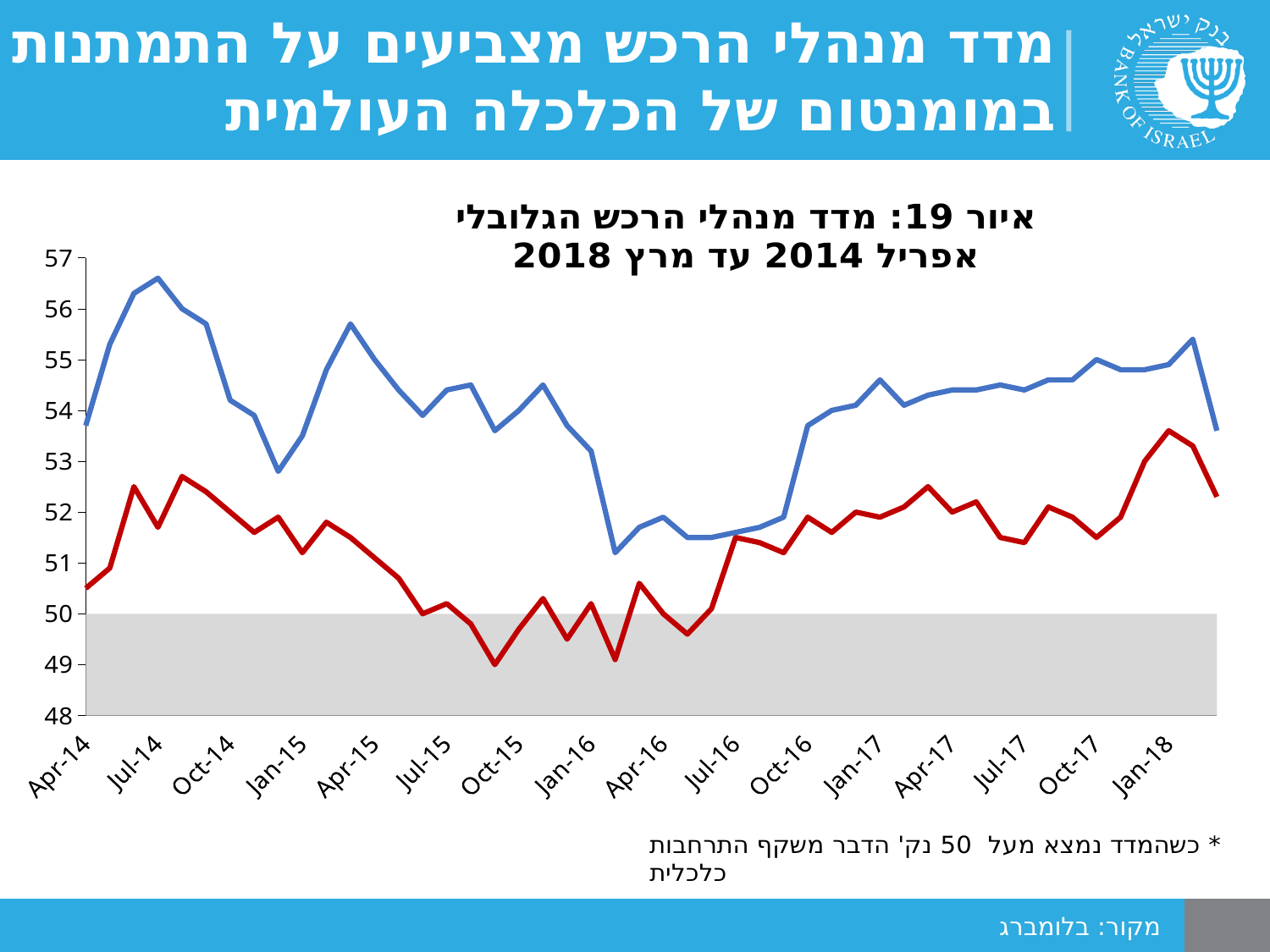
Below which y-axis value is the chart area shaded grey? 50 How many lines are plotted on the chart? 2 What kind of chart is shown on the slide? line chart At Jan-18, which line is higher, the blue line or the red line? the blue line Does the red line rise or fall overall between Jul-14 and Oct-15? fall Does the blue line rise or fall between Apr-16 and Oct-16? rise Is the value of the red line at Oct-15 greater or less than 50? less What is the lowest value shown on the y-axis? 48 Is the value of the blue line at Jul-14 greater or less than 56? greater Is the value of the red line at Apr-14 greater or less than 51? less